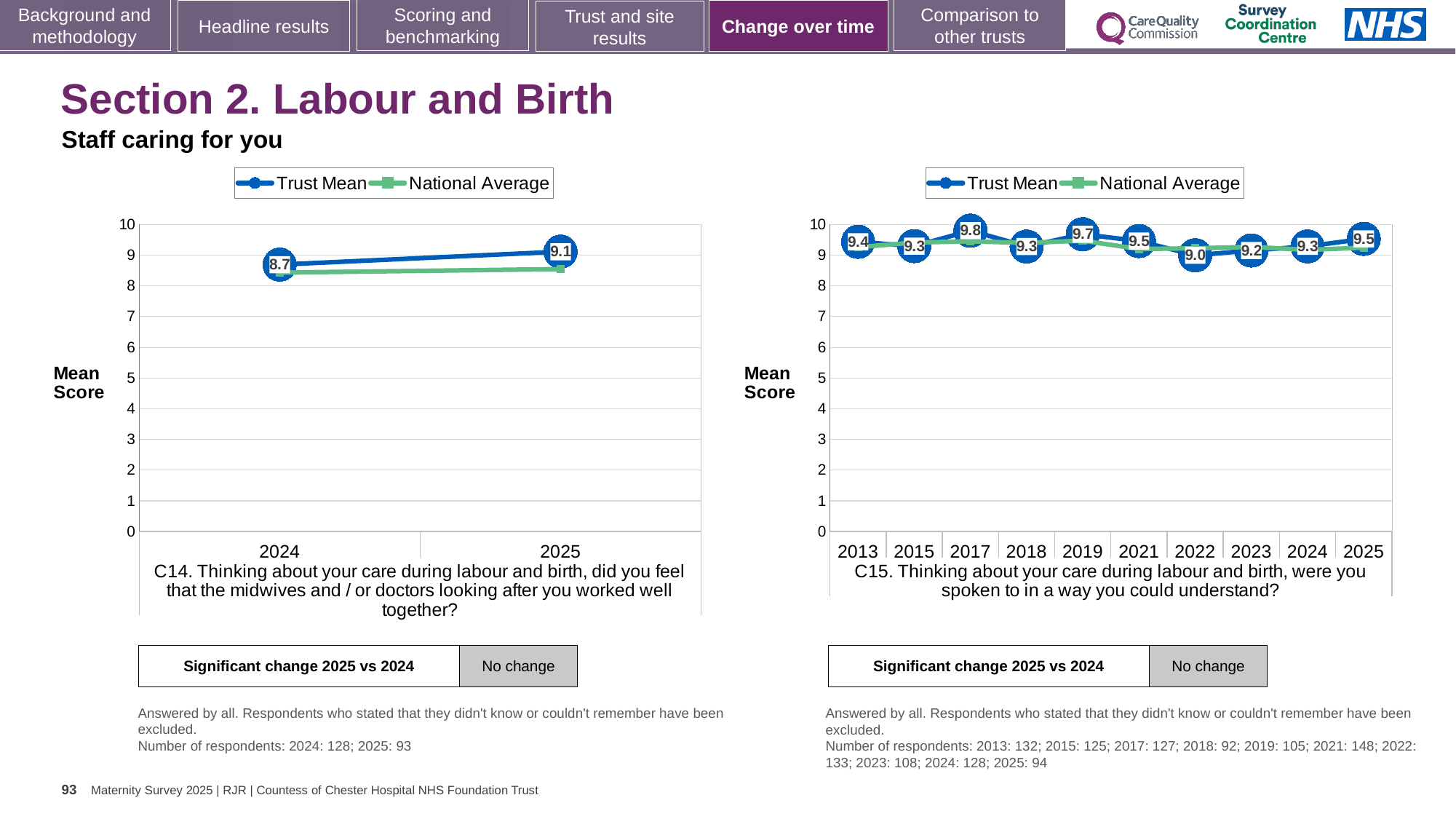
In the right chart (C15), what is the Trust Mean score for 2017? 9.8 In the right chart (C15), what is the Trust Mean score for 2022? 9.0 In the right chart (C15), how many years are plotted on the x axis? 10 In the right chart (C15), which year has the highest Trust Mean score? 2017 In the left chart (C14), what is the Trust Mean score for 2024? 8.7 In the left chart (C14), is the National Average for 2025 greater or less than 8? greater In the left chart (C14), what is the Trust Mean score for 2025? 9.1 In the left chart (C14), by how much did the Trust Mean change from 2024 to 2025? 0.4 How many series does the legend of the left chart list? 2 In the right chart (C15), what is the difference between the Trust Mean in 2017 and in 2022? 0.8 In the left chart (C14), does the Trust Mean rise or fall from 2024 to 2025? rise In the right chart (C15), which year has the lowest Trust Mean score? 2022